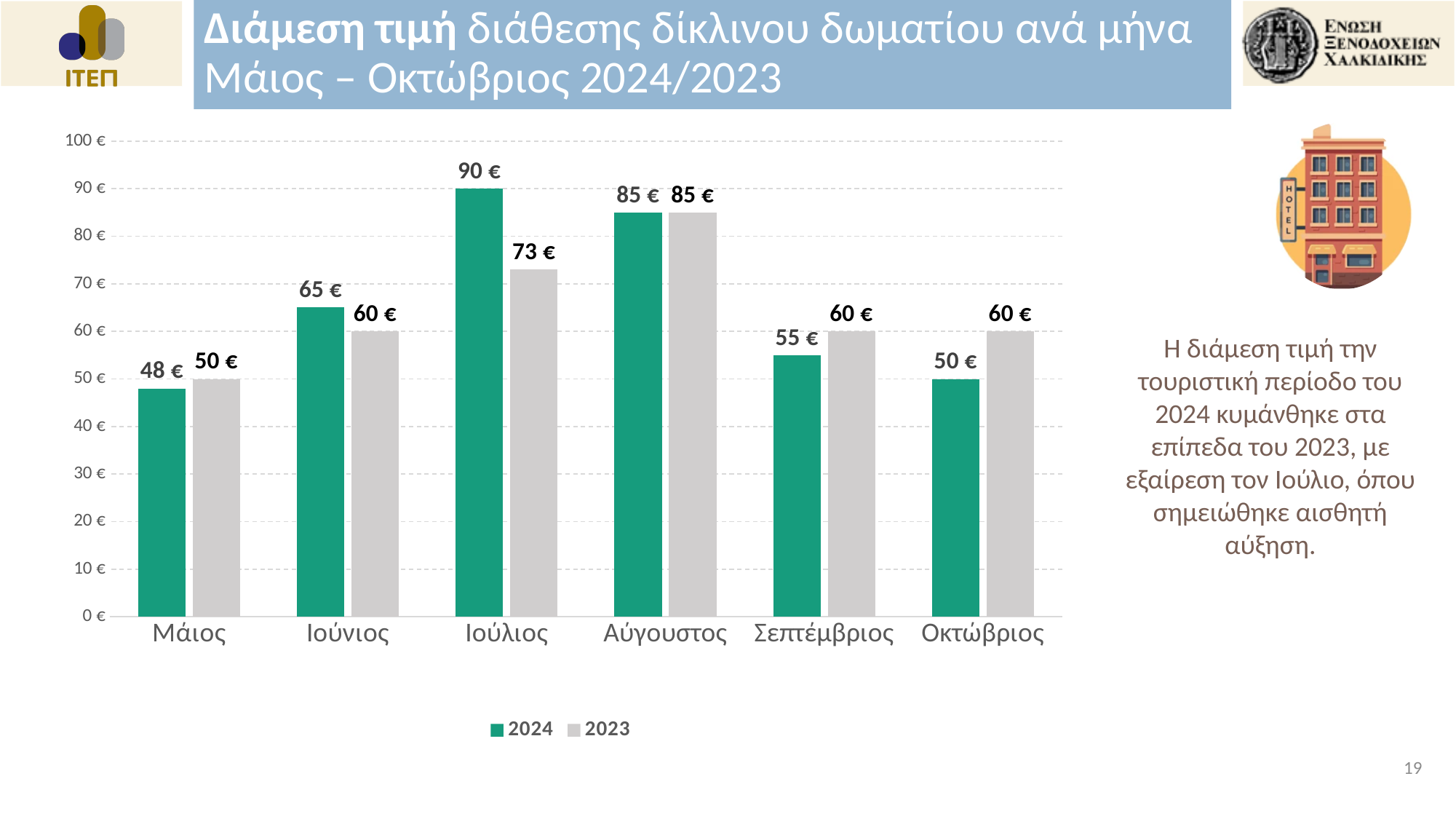
What is the 2024 value for Σεπτέμβριος? 55 € What kind of chart is shown on the slide? Bar chart Which month has the highest 2024 value? Ιούλιος Which colour represents the 2024 series in the legend? Green What is the difference between the 2024 values for Ιούνιος and Μάιος? 17 € Which month has the lowest 2024 value? Μάιος What is the difference between the 2024 and 2023 values for Ιούλιος? 17 € What is the 2024 value for Ιούλιος? 90 € How many months are shown on the x axis? 6 How many series does the legend list? 2 Which is larger for Οκτώβριος, the 2024 value or the 2023 value? 2023 What is the 2023 value for Μάιος? 50 €